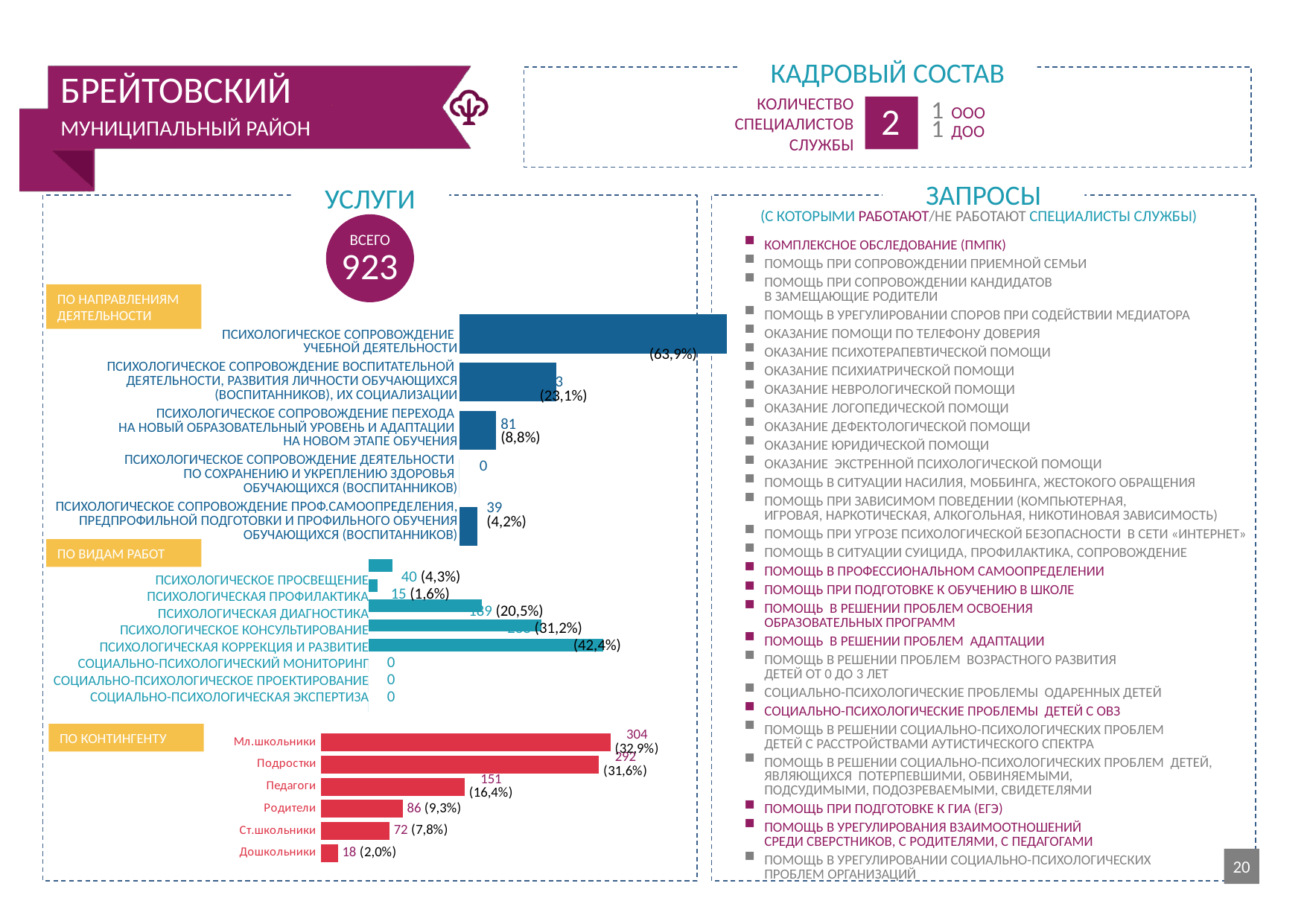
In the 'ПО КОНТИНГЕНТУ' chart, what is the value for Мл.школьники? 304 In the 'ПО НАПРАВЛЕНИЯМ ДЕЯТЕЛЬНОСТИ' chart, what percentage is shown for Психологическое сопровождение учебной деятельности? 63,9% In the 'ПО ВИДАМ РАБОТ' chart, what percentage is shown for Психологическая коррекция и развитие? 42,4% In the 'ПО НАПРАВЛЕНИЯМ ДЕЯТЕЛЬНОСТИ' chart, what is the value for Психологическое сопровождение перехода на новый образовательный уровень и адаптации на новом этапе обучения? 81 What kind of chart is the 'ПО КОНТИНГЕНТУ' chart? Bar chart In the 'ПО ВИДАМ РАБОТ' chart, what is the value for Психологическое просвещение? 40 In the 'ПО ВИДАМ РАБОТ' chart, which is larger: Психологическое консультирование or Психологическая диагностика? Психологическое консультирование In the 'ПО КОНТИНГЕНТУ' chart, which category has the lowest value? Дошкольники In the 'ПО КОНТИНГЕНТУ' chart, what percentage is shown for Педагоги? 16,4% In the 'ПО КОНТИНГЕНТУ' chart, what is the difference between the values for Родители and Ст.школьники? 14 In the 'ПО КОНТИНГЕНТУ' chart, how many categories are shown? 6 In the 'ПО КОНТИНГЕНТУ' chart, which category has the highest value? Мл.школьники